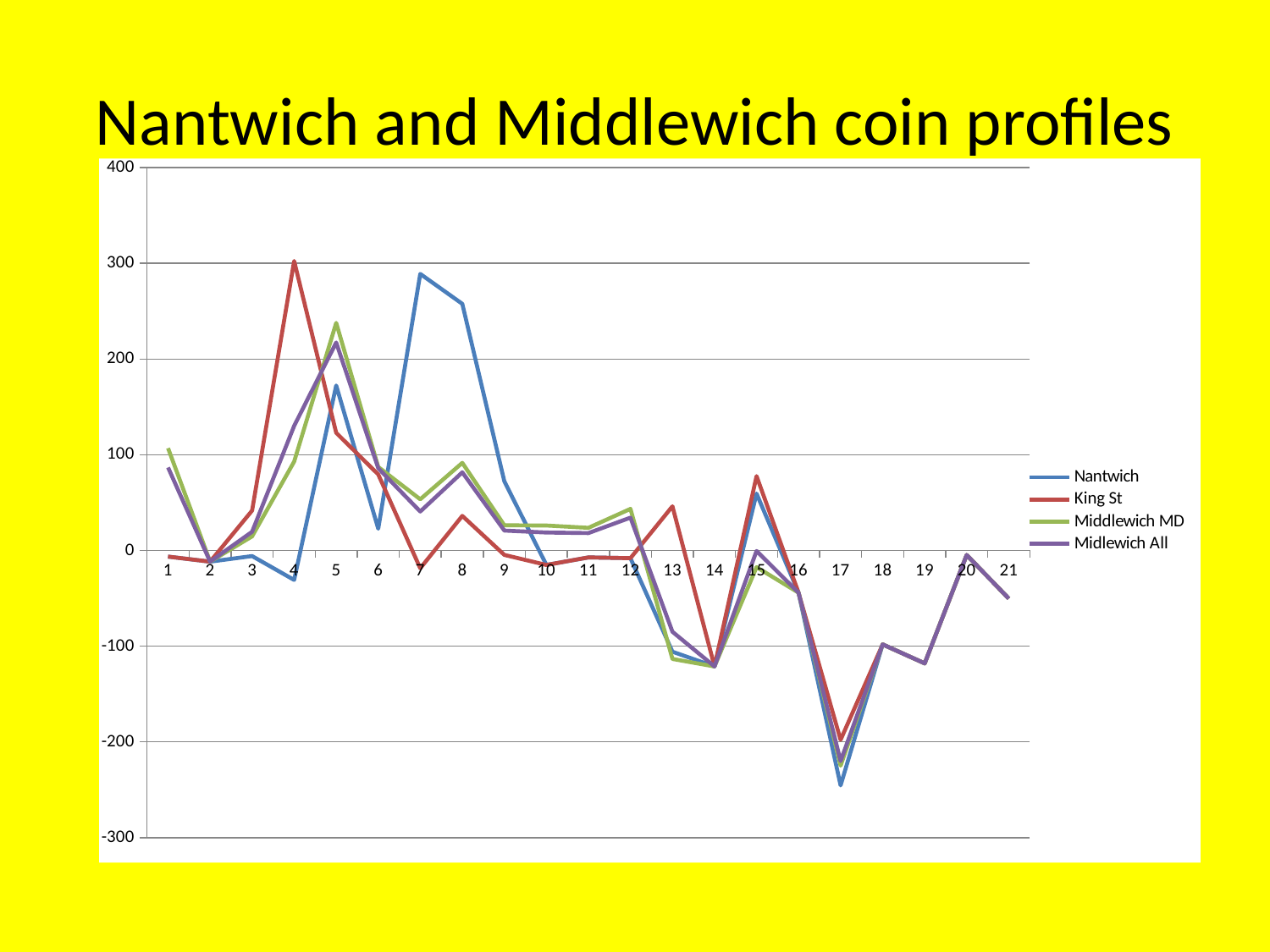
How many series does the legend list? 4 Is the value for Middlewich MD at point 5 greater or less than 200? greater Is the value for Nantwich at point 17 greater or less than -200? less Which series reaches the lowest value anywhere on the chart? Nantwich At point 7, which series has the higher value, Nantwich or King St? Nantwich What is the title of the chart? Nantwich and Middlewich coin profiles What kind of chart is shown on the slide? line chart Is the value for King St at point 4 greater or less than 200? greater How many points are there along the x axis? 21 At point 4, which series has the higher value, King St or Nantwich? King St Which colour is used for the King St series? red